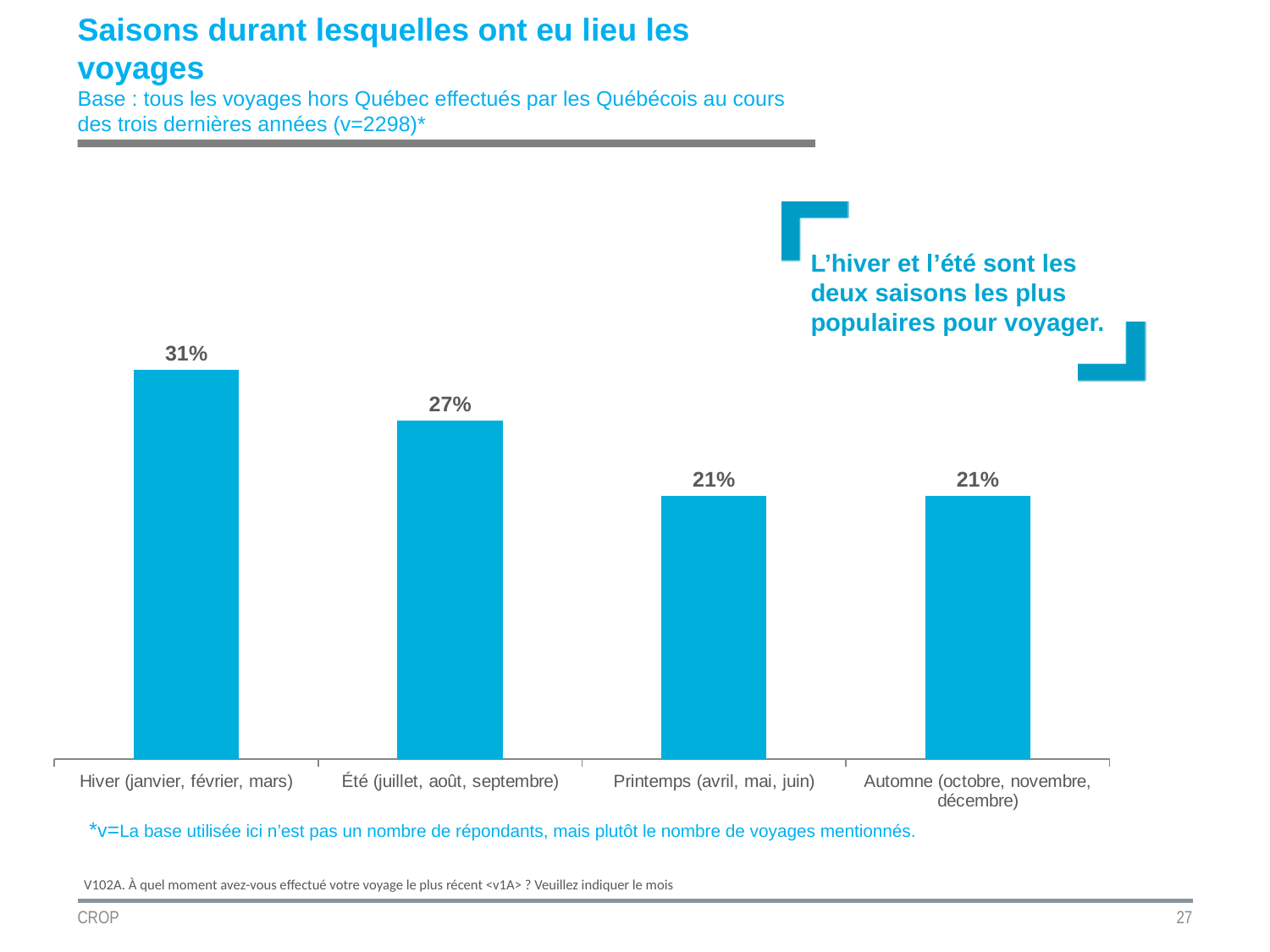
Do the values rise or fall from Hiver to Printemps along the x axis? Fall What is the title of the chart on the slide? Saisons durant lesquelles ont eu lieu les voyages How many seasons are shown on the chart? 4 What is the value for Automne (octobre, novembre, décembre)? 21% What is the difference between the values for Hiver and Été? 4% Which season has the highest value? Hiver (janvier, février, mars) What is the difference between the values for Été and Printemps? 6% Which is larger, the value for Hiver or the value for Automne? Hiver What is the value for Hiver (janvier, février, mars)? 31% What is the value for Printemps (avril, mai, juin)? 21% What is the value for Été (juillet, août, septembre)? 27% What kind of chart is shown on the slide? Bar chart